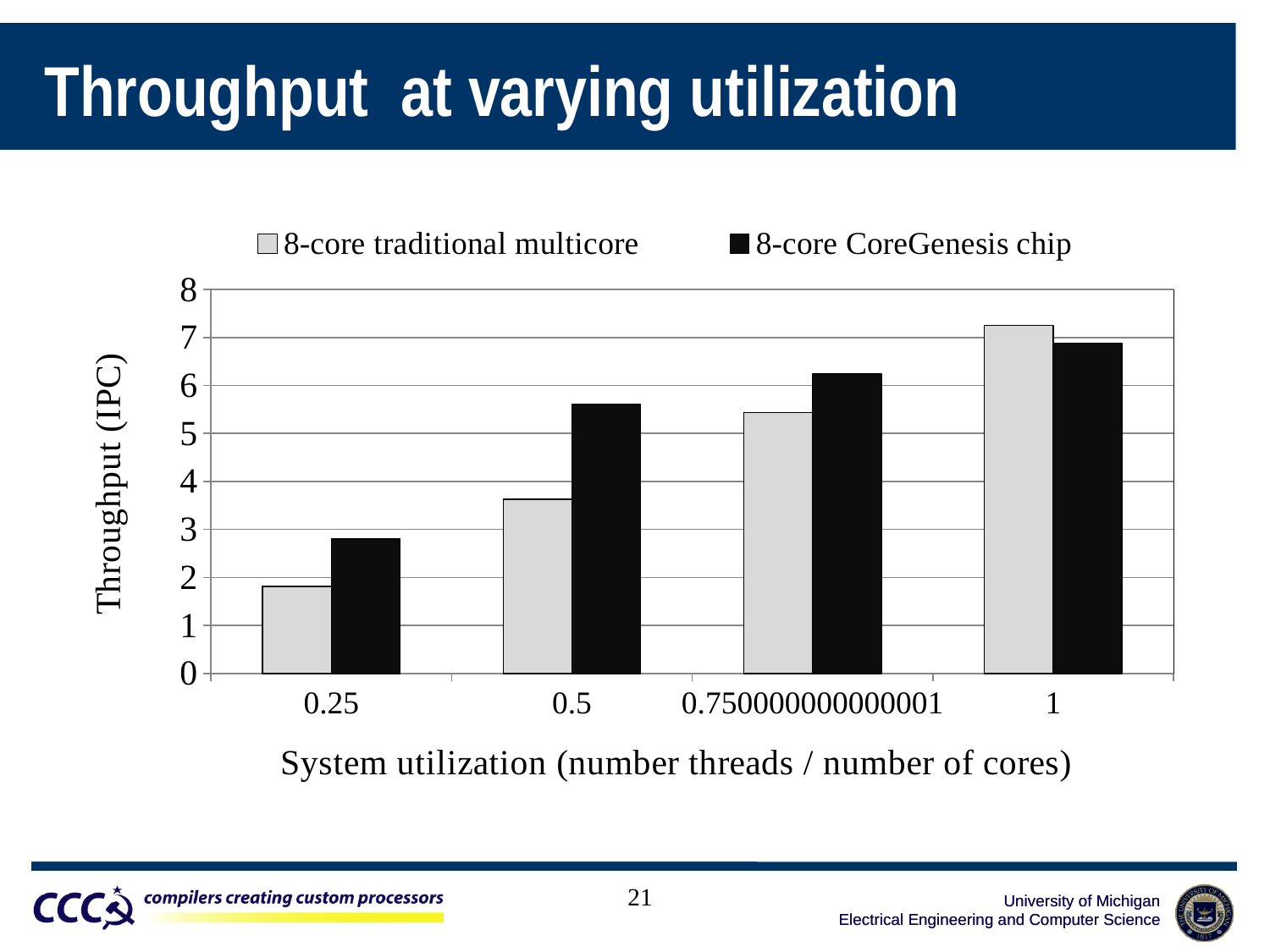
What kind of chart is shown on the slide? bar chart At system utilization 0.5, which series has the higher throughput? 8-core CoreGenesis chip Is the throughput of the 8-core traditional multicore at utilization 1 greater or less than 7? greater How many system utilization categories are shown on the x axis? 4 At which system utilization is the throughput of the 8-core traditional multicore highest? 1 How many series does the legend list? 2 At system utilization 0.25, which series has the higher throughput? 8-core CoreGenesis chip Is the throughput of the 8-core CoreGenesis chip at utilization 0.5 greater or less than 5? greater What is the label of the y axis? Throughput (IPC) Does the throughput of the 8-core traditional multicore rise or fall as system utilization increases? rise At which system utilization is the throughput of the 8-core CoreGenesis chip lowest? 0.25 Is the throughput of the 8-core traditional multicore at utilization 0.5 greater or less than 4? less